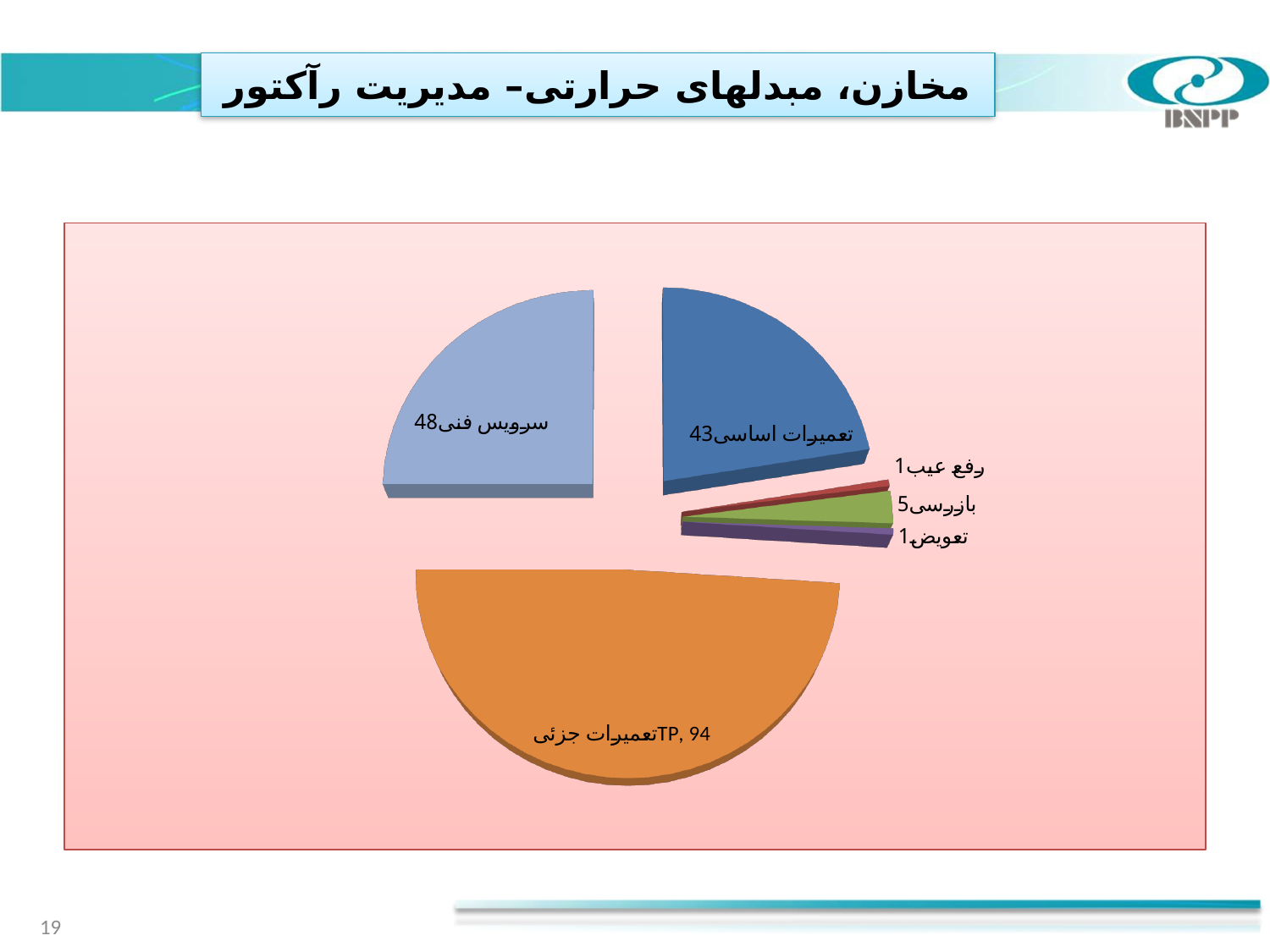
What is the value for بازرسی? 5 What is the value for رفع عیب? 1 What is the difference between the values for تعمیرات جزئی and سرویس فنی? 46 What kind of chart is shown on the slide? Pie chart What is the value for تعمیرات جزئی (TP)? 94 Which category has the largest slice of the pie? تعمیرات جزئی (TP) What is the value for سرویس فنی? 48 What share of the pie does سرویس فنی represent? 25% What is the total of all the values shown in the pie chart? 192 How many slices does the pie chart have? 6 What is the value for تعمیرات اساسی? 43 Which is larger, the value for سرویس فنی or the value for تعمیرات اساسی? سرویس فنی